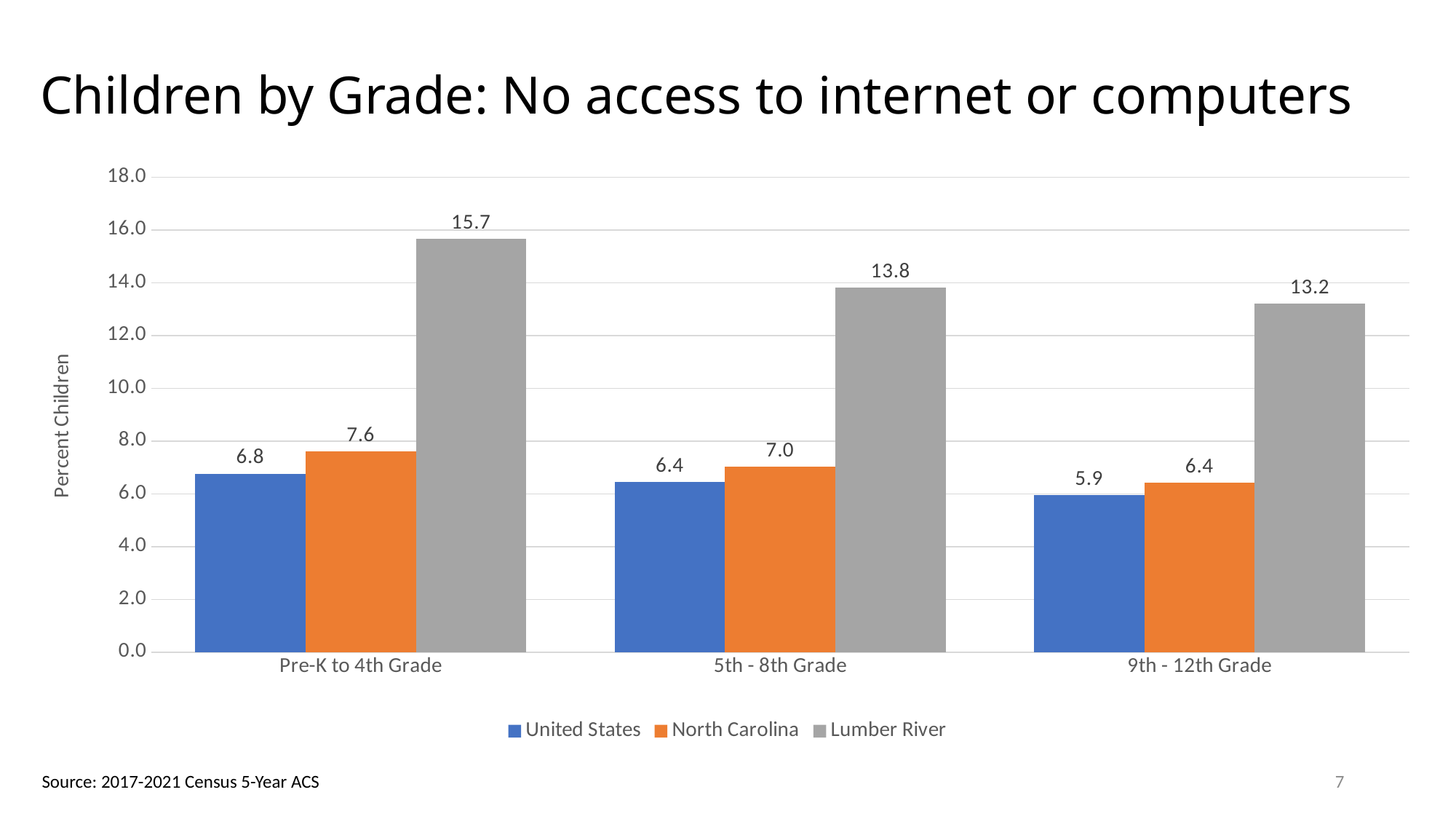
Which grade category has the highest Lumber River value? Pre-K to 4th Grade What is the difference between the Lumber River and United States values for 5th - 8th Grade? 7.4 What is the value for North Carolina in the 5th - 8th Grade category? 7.0 Do the Lumber River values rise or fall from Pre-K to 4th Grade to 9th - 12th Grade? Fall Which grade category has the lowest United States value? 9th - 12th Grade How many grade categories are shown on the x axis? 3 Is the Lumber River value for 9th - 12th Grade greater or less than 12.0? greater What is the value for Lumber River in the Pre-K to 4th Grade category? 15.7 What kind of chart is shown on the slide? Bar chart What is the value for United States in the 9th - 12th Grade category? 5.9 How many series does the legend list? 3 Which is larger in the 9th - 12th Grade category: North Carolina or United States? North Carolina